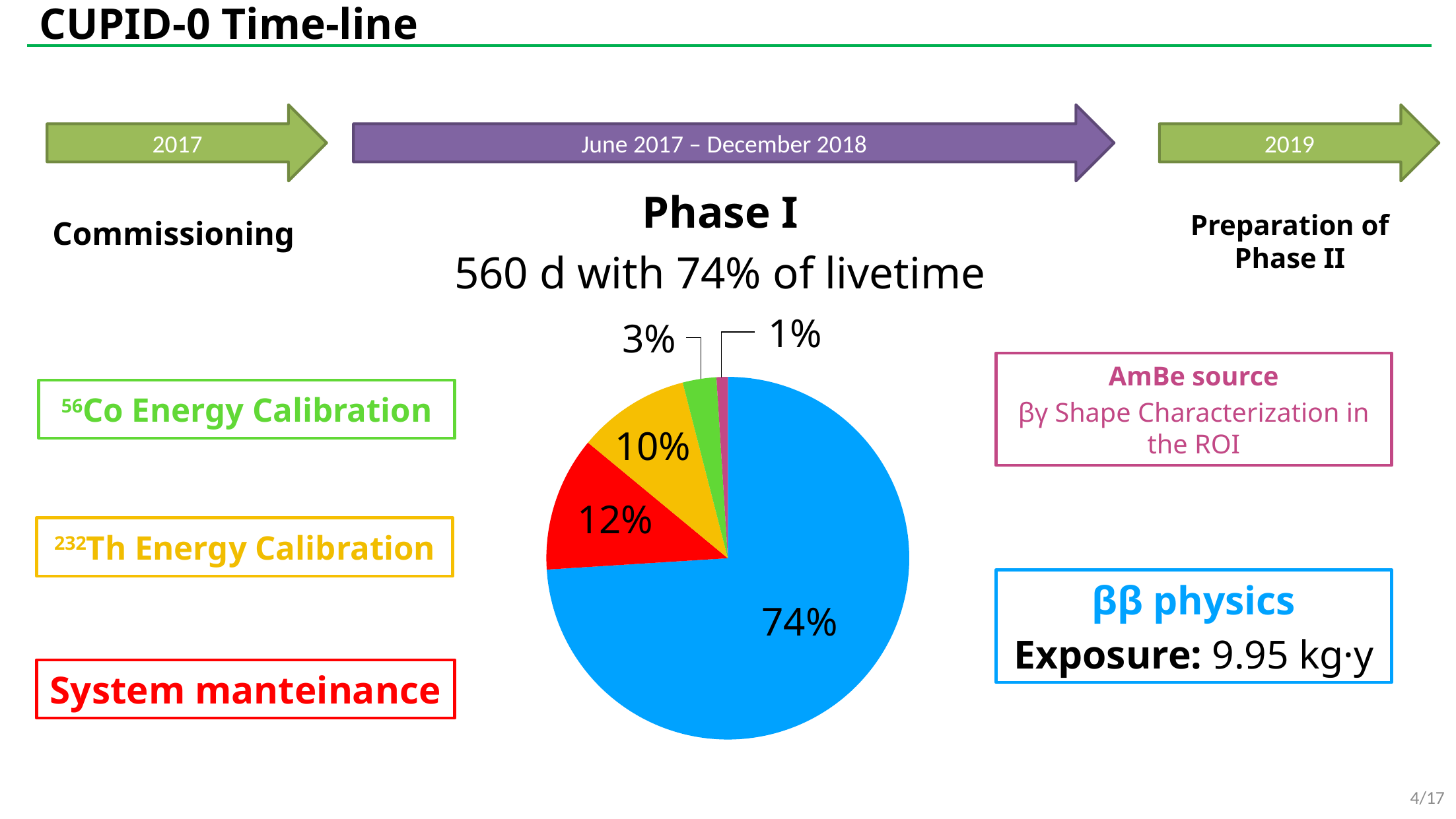
What share of the pie is labelled for the green slice (56Co Energy Calibration)? 3% What share of the pie does the largest slice (ββ physics, blue) take? 74% Which slice of the pie chart is the largest? ββ physics (74%) What share of the pie is labelled for the yellow slice (232Th Energy Calibration)? 10% What is the smallest share shown on the pie chart? 1% What is the difference between the 12% slice and the 10% slice? 2% What kind of chart is shown on the slide? pie chart How many slices does the pie chart have? 5 What colour is the slice representing ββ physics? blue What is the difference between the largest slice (74%) and the smallest slice (1%)? 73% Which is larger, the red slice (System manteinance) or the yellow slice (232Th Energy Calibration)? the red slice (System manteinance) What share of the pie is labelled for the red slice (System manteinance)? 12%